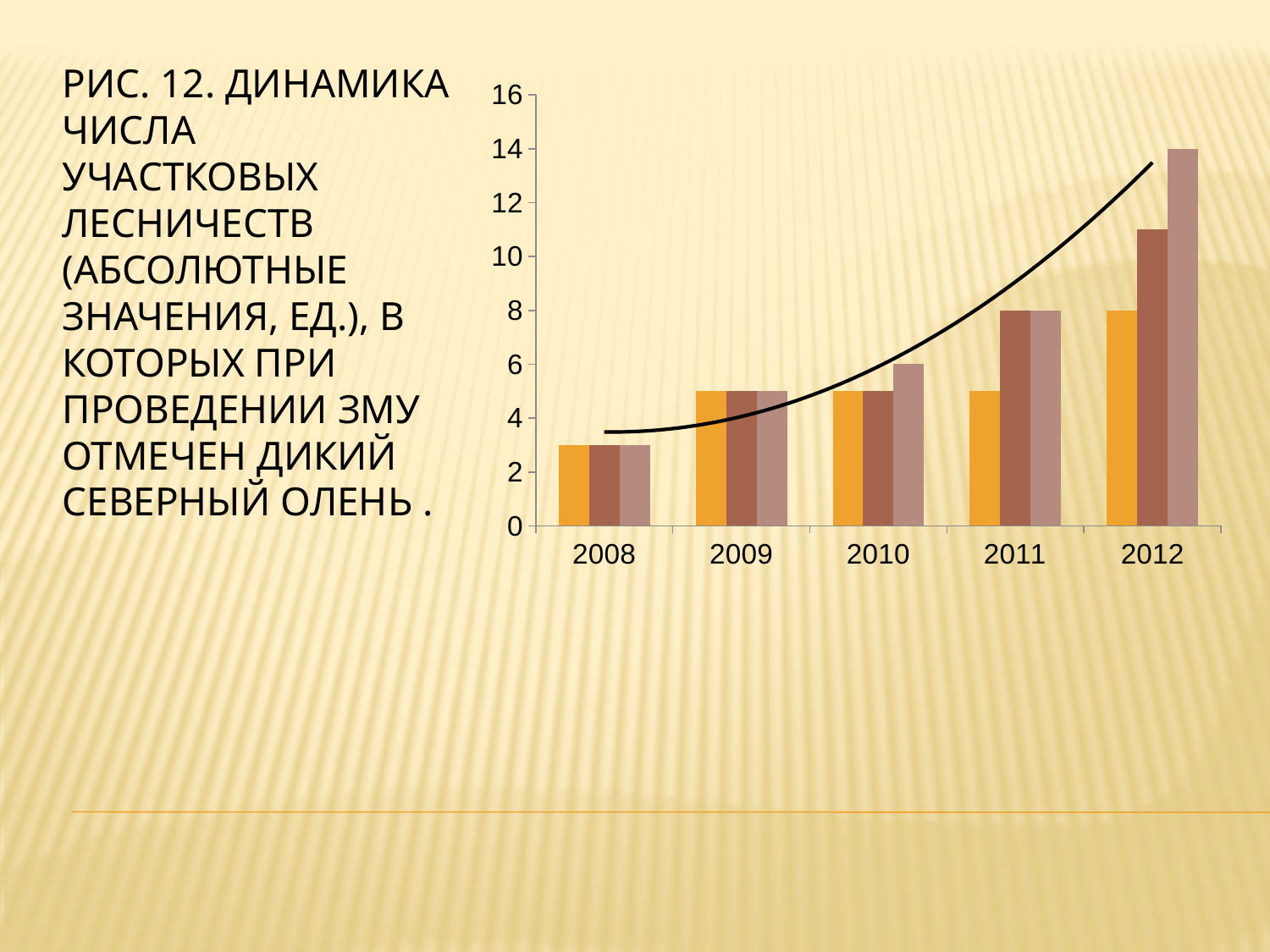
Which is larger: the orange bar for 2011 or the orange bar for 2012? 2012 Which year has the shortest bars in the chart? 2008 Is the value of the dark brown bar for 2012 greater or less than 10? greater What is the value of the tallest (light brown) bar for 2012? 14 What is the value of the dark brown (second) bar for 2011? 8 What is the value of the orange bar for 2012? 8 Is the value of the orange bar for 2008 greater or less than 4? less Which year has the tallest bar in the chart? 2012 What is the value of the light brown (third) bar for 2010? 6 Do the values in the chart generally rise or fall from 2008 to 2012? rise How many years are shown on the x axis of the chart? 5 What kind of chart is shown on the slide? bar chart